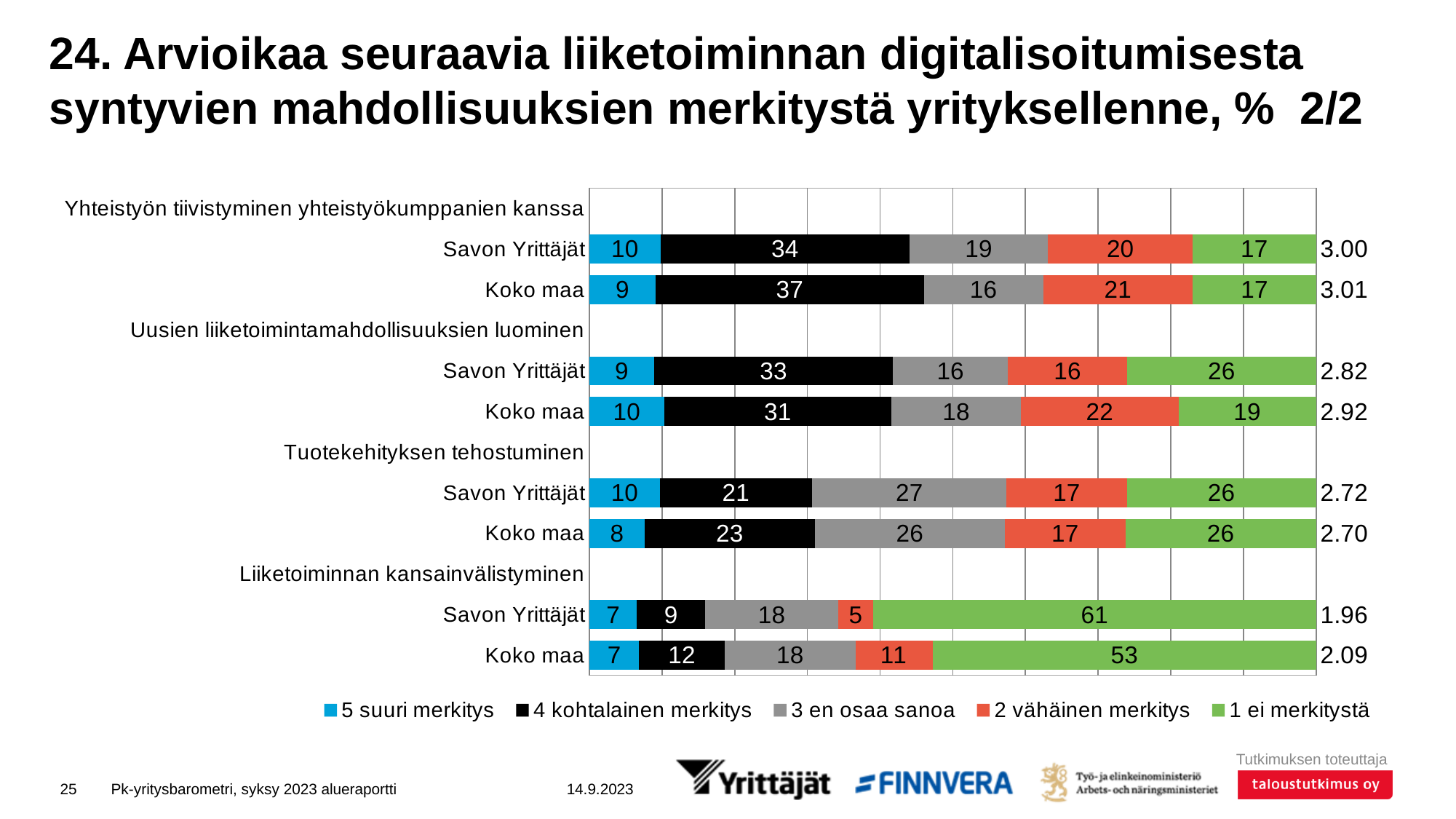
What is the value of the "5 suuri merkitys" segment for Koko maa under Tuotekehityksen tehostuminen? 8 What is the mean score shown at the end of the Savon Yrittäjät bar under Tuotekehityksen tehostuminen? 2.72 What kind of chart is shown on the slide? Stacked bar chart What is the total of the Savon Yrittäjät bar under Liiketoiminnan kansainvälistyminen? 100 Which bar has the largest "1 ei merkitystä" segment? Savon Yrittäjät, Liiketoiminnan kansainvälistyminen What is the value of the "1 ei merkitystä" segment for Savon Yrittäjät under Liiketoiminnan kansainvälistyminen? 61 What is the value of the "4 kohtalainen merkitys" segment for Koko maa under Yhteistyön tiivistyminen yhteistyökumppanien kanssa? 37 How many stacked bars are plotted in the chart? 8 How many series does the legend list? 5 Which bar has the smallest "2 vähäinen merkitys" segment? Savon Yrittäjät, Liiketoiminnan kansainvälistyminen Under Liiketoiminnan kansainvälistyminen, which has the larger "1 ei merkitystä" value, Savon Yrittäjät or Koko maa? Savon Yrittäjät Under Liiketoiminnan kansainvälistyminen, what is the difference between the "2 vähäinen merkitys" values for Koko maa and Savon Yrittäjät? 6